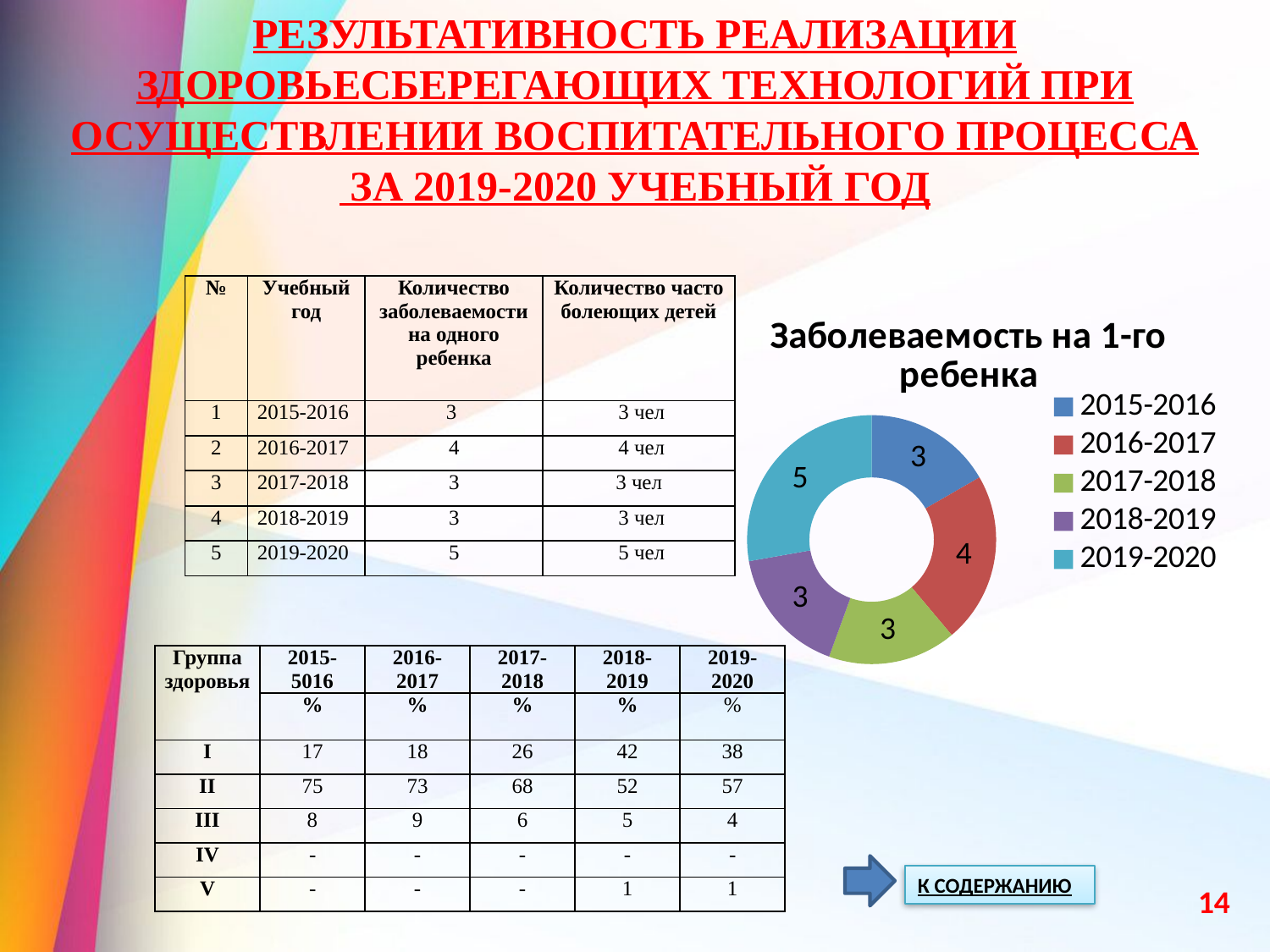
What is the difference between the values for 2019-2020 and 2016-2017 in the doughnut chart? 1 Which school year has the highest value in the doughnut chart? 2019-2020 What kind of chart is shown on the slide? Doughnut (pie) chart What is the difference between the values for 2019-2020 and 2017-2018 in the doughnut chart? 2 Which is larger in the doughnut chart, the value for 2016-2017 or the value for 2018-2019? 2016-2017 What is the value for 2018-2019 in the doughnut chart? 3 What is the title of the chart on the slide? Заболеваемость на 1-го ребенка How many entries does the legend of the doughnut chart list? 5 What is the value for 2016-2017 in the doughnut chart? 4 How many slices does the doughnut chart have? 5 What is the value for 2015-2016 in the doughnut chart? 3 What is the value for 2019-2020 in the doughnut chart? 5